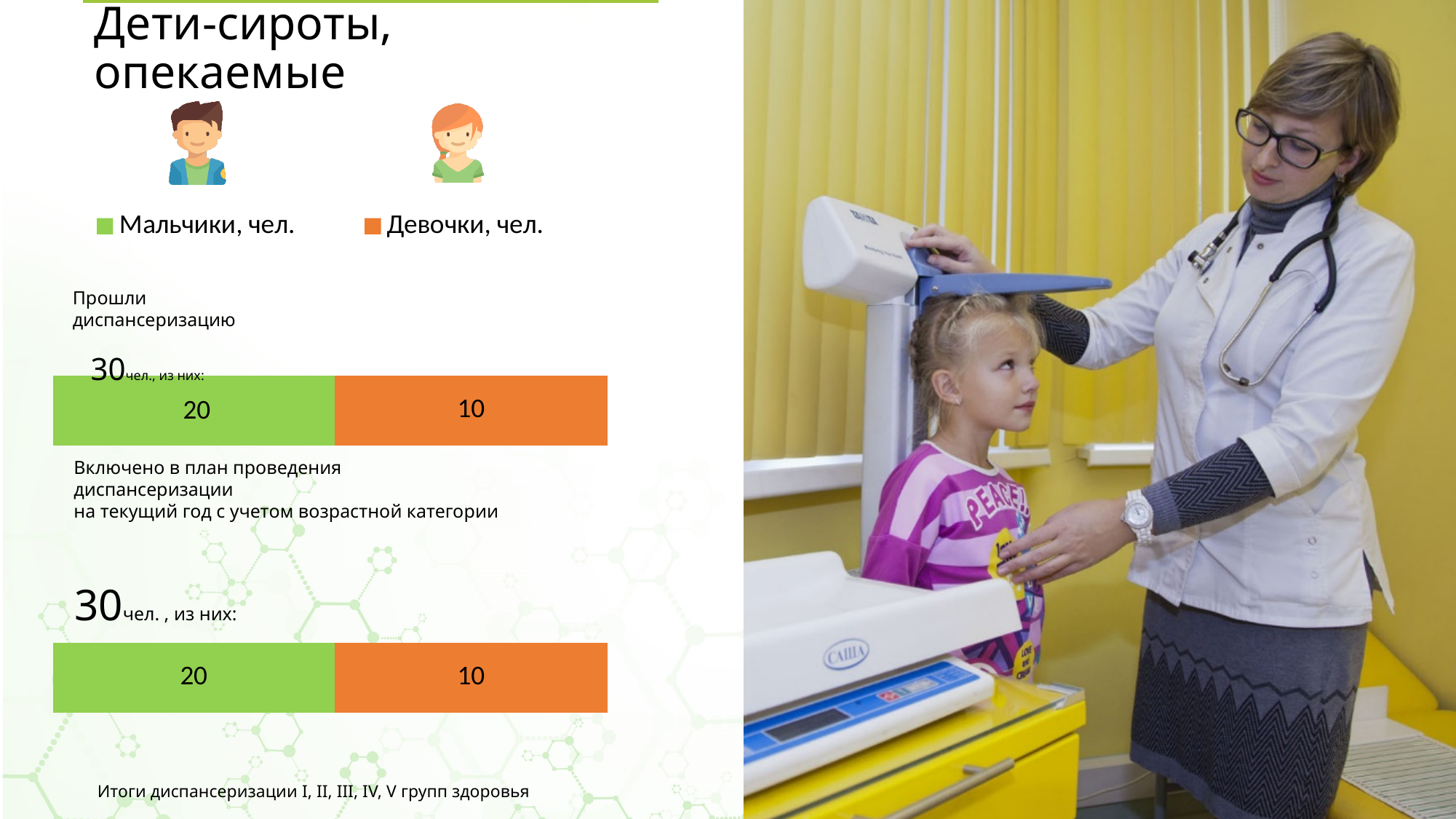
What colour represents Девочки in the legend? Orange In the lower chart (Включено в план проведения диспансеризации), what is the total of the stacked bar? 30 In the lower chart (Включено в план проведения диспансеризации), what is the value for Девочки? 10 In the upper chart (Прошли диспансеризацию), which series has the highest value? Мальчики In the upper chart (Прошли диспансеризацию), what is the difference between the values for Мальчики and Девочки? 10 In the upper chart (Прошли диспансеризацию), what is the value for Мальчики? 20 How many series does the legend list? 2 What kind of chart is the upper chart (Прошли диспансеризацию)? Stacked bar chart In the lower chart (Включено в план проведения диспансеризации), what is the value for Мальчики? 20 In the upper chart (Прошли диспансеризацию), what is the total of the stacked bar? 30 In the lower chart (Включено в план проведения диспансеризации), which is larger, Мальчики or Девочки? Мальчики In the upper chart (Прошли диспансеризацию), what is the value for Девочки? 10